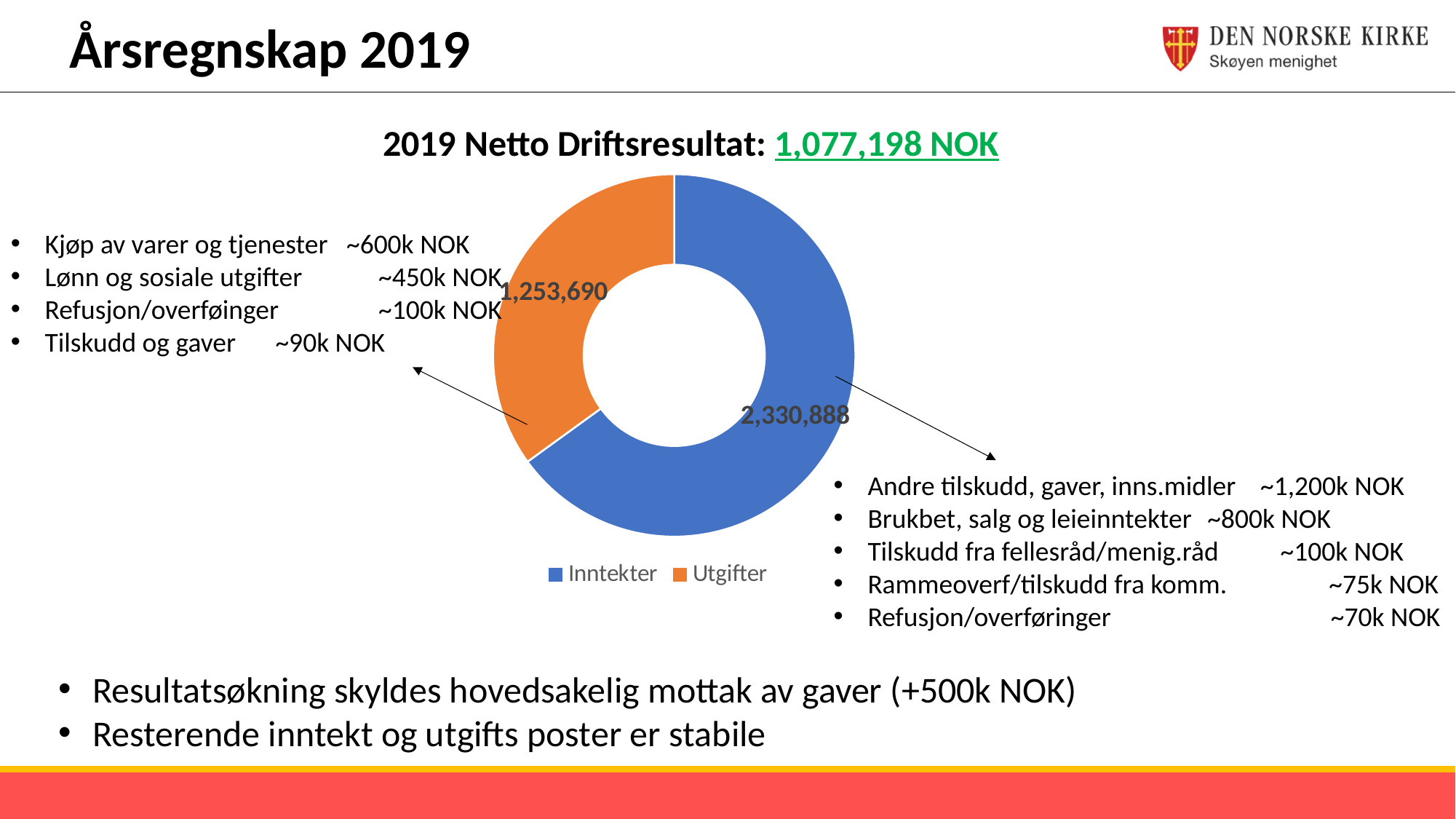
Which category has the larger value in the chart, Inntekter or Utgifter? Inntekter How many entries does the chart legend list? 2 Which slice of the chart is the largest? Inntekter What colour is the Utgifter slice in the chart? Orange How many slices does the chart have? 2 What is the total of the two values shown in the chart? 3,584,578 What type of chart is shown on the slide? Doughnut chart Which slice of the chart is the smallest? Utgifter What is the value shown for Inntekter in the doughnut chart? 2,330,888 What is the value shown for Utgifter in the doughnut chart? 1,253,690 What is the difference between the Inntekter and Utgifter values in the chart? 1,077,198